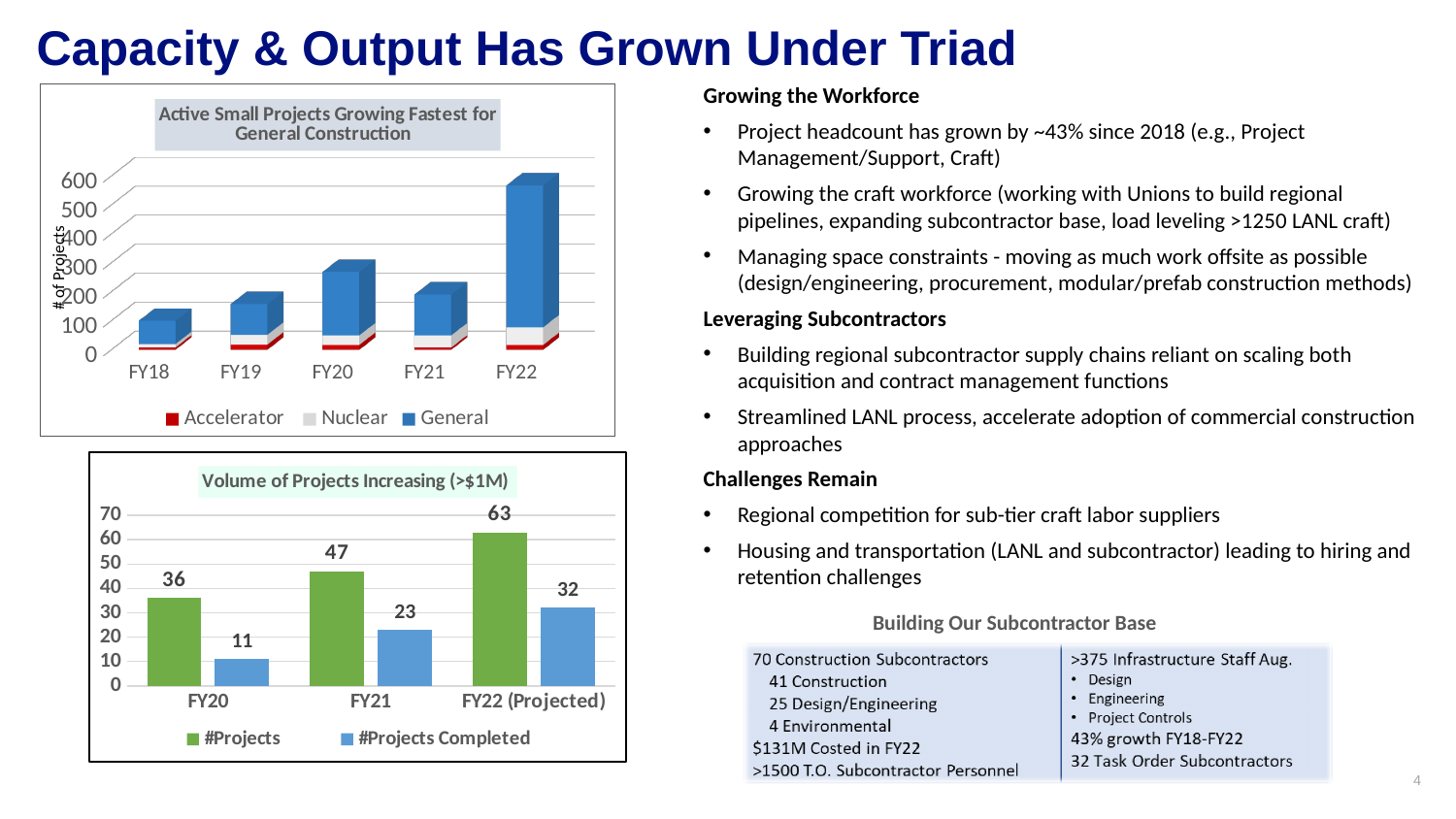
In the 'Volume of Projects Increasing (>$1M)' chart, does the #Projects series rise or fall from FY20 to FY22 (Projected)? rise In the 'Volume of Projects Increasing (>$1M)' chart, what is the value of #Projects for FY21? 47 In the 'Active Small Projects Growing Fastest for General Construction' chart, is the total for FY22 greater or less than 500? greater In the 'Volume of Projects Increasing (>$1M)' chart, what is the value of #Projects Completed for FY20? 11 In the 'Volume of Projects Increasing (>$1M)' chart, what is the value of #Projects for FY22 (Projected)? 63 In the 'Active Small Projects Growing Fastest for General Construction' chart, how many series does the legend list? 3 In the 'Volume of Projects Increasing (>$1M)' chart, what is the difference between #Projects and #Projects Completed for FY21? 24 What type of chart is the 'Active Small Projects Growing Fastest for General Construction' chart? stacked bar chart In the 'Volume of Projects Increasing (>$1M)' chart, how many series does the legend list? 2 In the 'Volume of Projects Increasing (>$1M)' chart, which is larger: #Projects for FY20 or #Projects Completed for FY22 (Projected)? #Projects for FY20 In the 'Active Small Projects Growing Fastest for General Construction' chart, which fiscal year has the tallest stacked bar? FY22 In the 'Volume of Projects Increasing (>$1M)' chart, which category has the highest #Projects Completed value? FY22 (Projected)